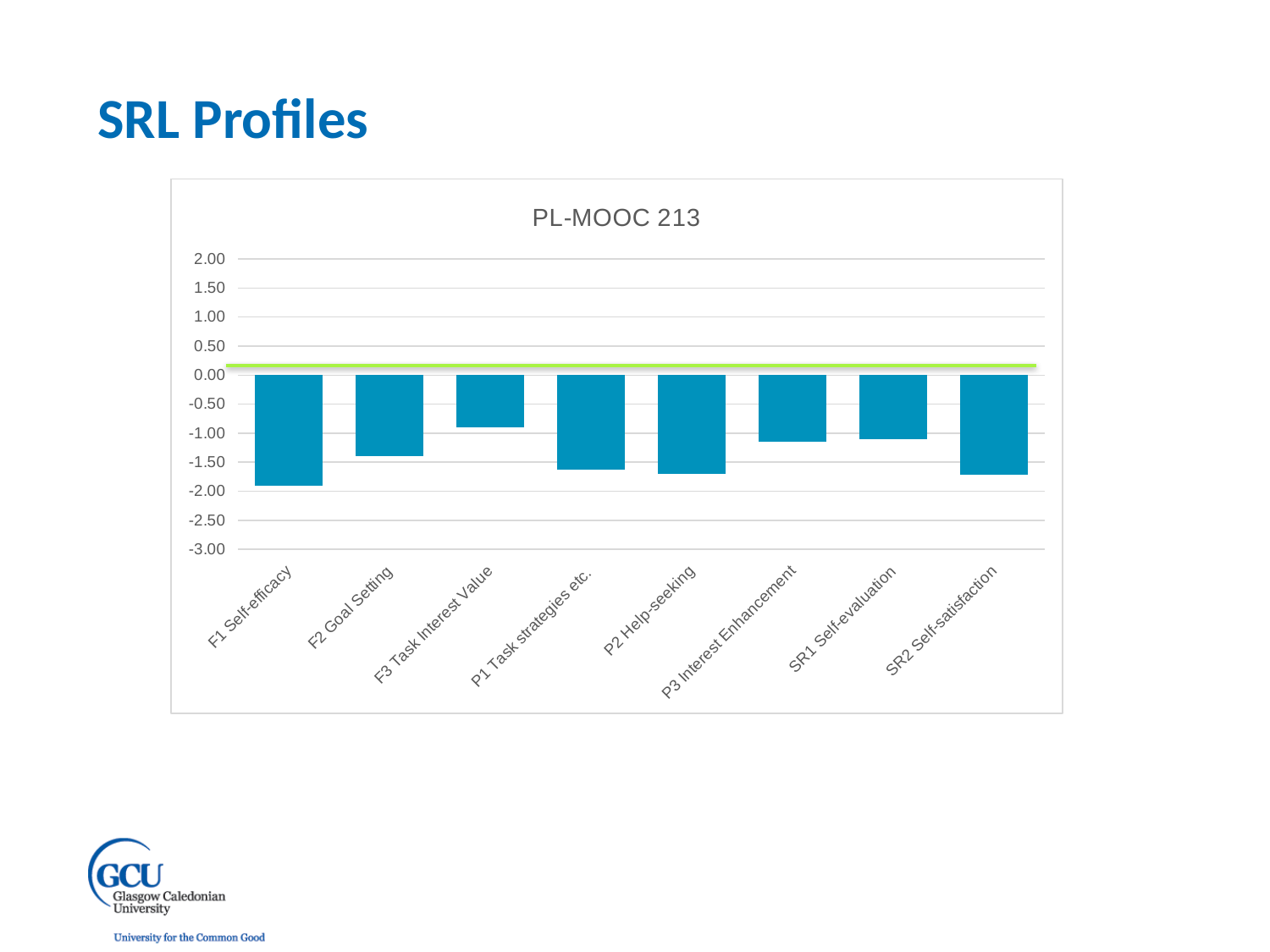
Which has the larger value, F3 Task Interest Value or P2 Help-seeking? F3 Task Interest Value Which category has the highest value (closest to zero) in the chart? F3 Task Interest Value How many categories are plotted on the x axis of the chart? 8 Is the value for F3 Task Interest Value greater or less than -1.00? greater Which category has the lowest value in the chart? F1 Self-efficacy Are the bars in the chart positive or negative? negative Which has the larger value, F1 Self-efficacy or F2 Goal Setting? F2 Goal Setting What kind of chart is shown on the slide? bar chart Is the value for F2 Goal Setting greater or less than -1.00? less Is the value for F1 Self-efficacy greater or less than -1.50? less What is the title of the chart? PL-MOOC 213